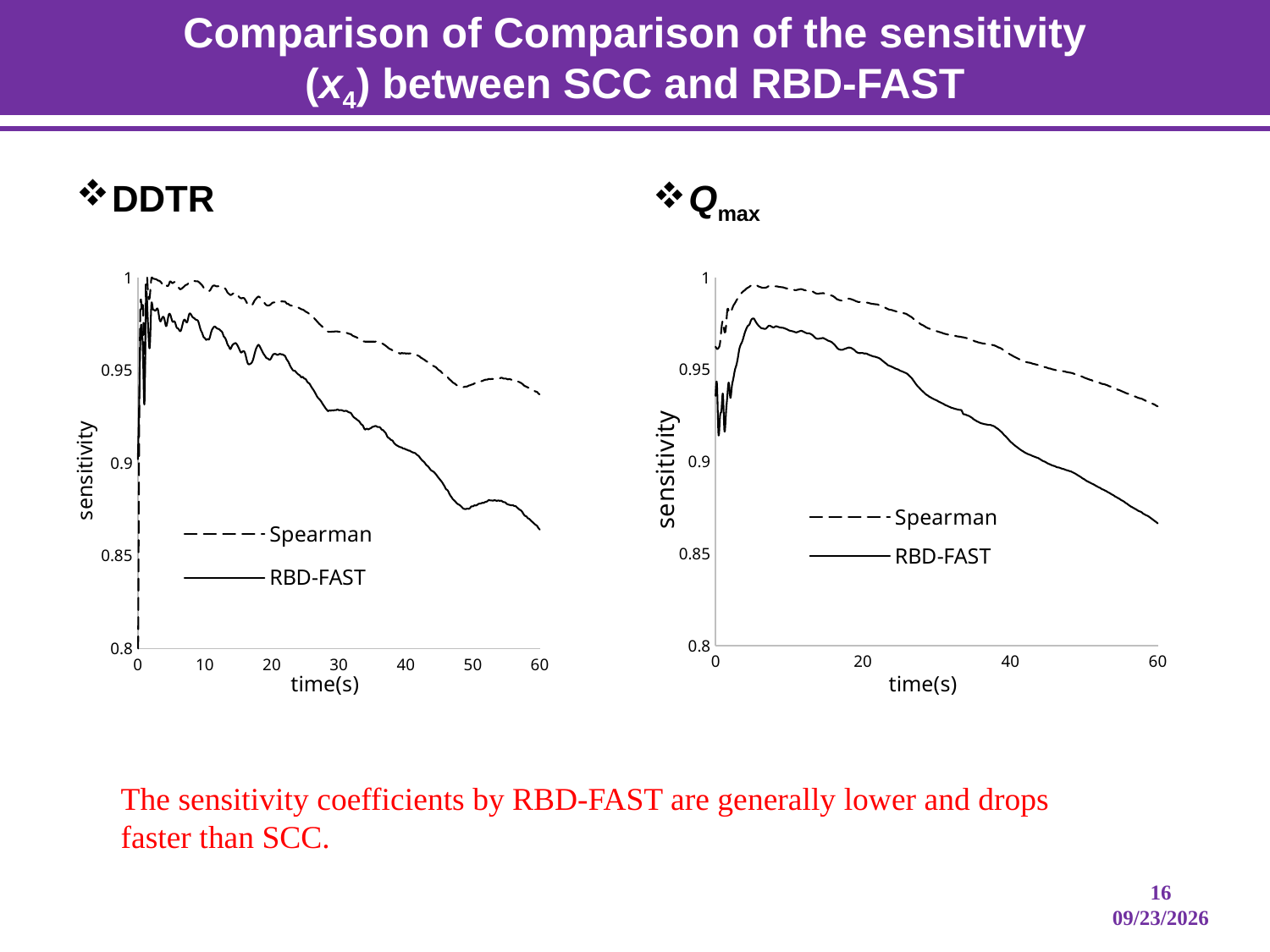
In the Qmax chart, is the RBD-FAST sensitivity at time 60 s greater or less than 0.9? less How many series does the legend of the DDTR chart list? 2 In the Qmax chart, which series has the lower sensitivity at time 50 s, Spearman or RBD-FAST? RBD-FAST What kind of chart is the Qmax chart on the right? line chart In the DDTR chart, which series has the higher sensitivity at time 40 s, Spearman or RBD-FAST? Spearman In the DDTR chart, is the RBD-FAST sensitivity at time 60 s greater or less than 0.9? less What is the label of the x axis on the DDTR chart? time(s) In the DDTR chart, does the RBD-FAST sensitivity generally rise or fall as time increases from 10 s to 60 s? fall What kind of chart is the DDTR chart on the left? line chart In the Qmax chart, does the Spearman sensitivity generally rise or fall as time increases from 10 s to 60 s? fall In the Qmax chart, is the Spearman sensitivity at time 60 s greater or less than 0.9? greater How many series does the legend of the Qmax chart list? 2